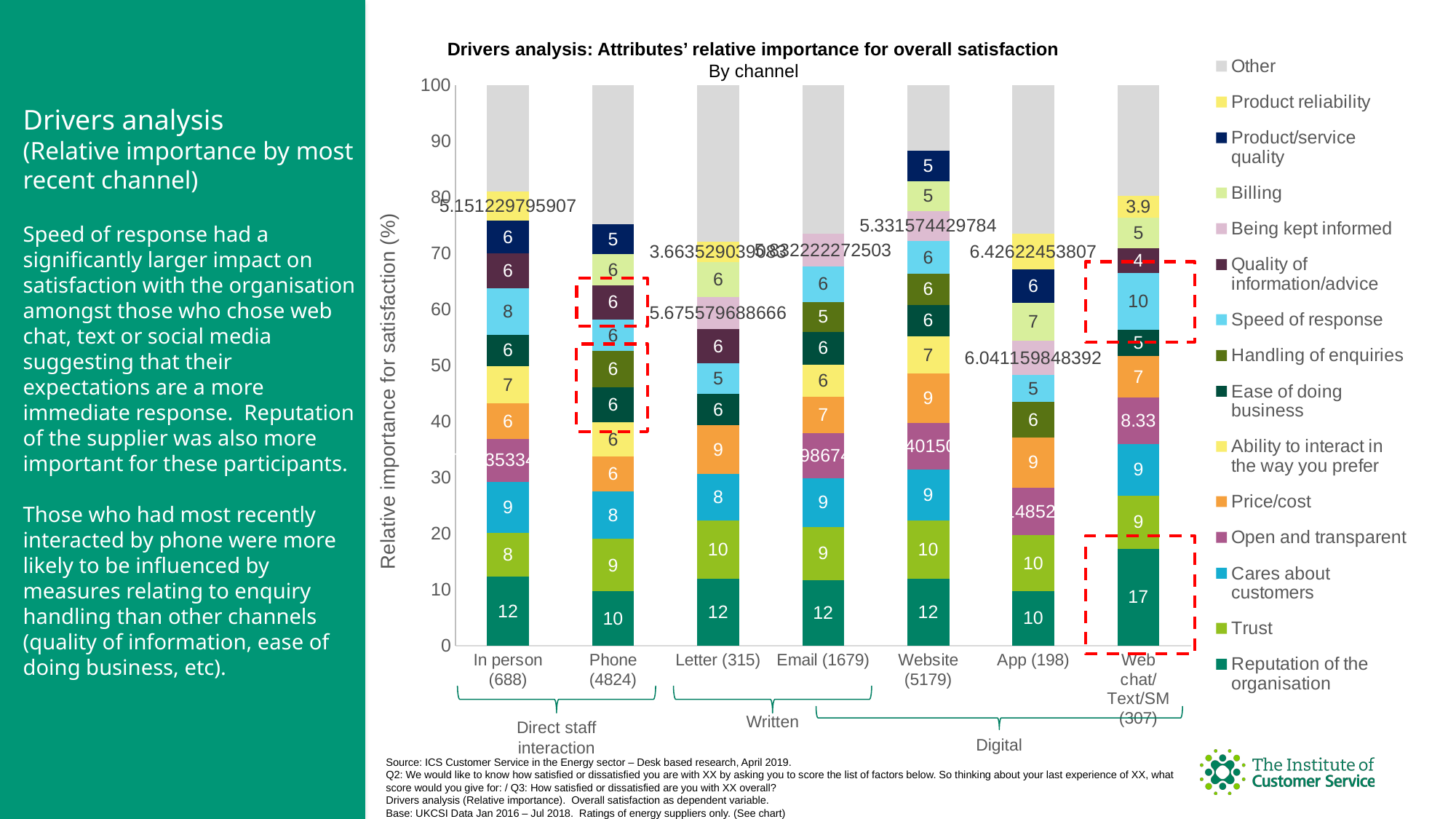
How many channels are plotted along the x axis of the chart? 7 Which channel has the highest value for Reputation of the organisation? Web chat/Text/SM (307) What is the value for Price/cost for the Website (5179) channel? 9 What is the value for Reputation of the organisation for the Web chat/Text/SM (307) channel? 17 What is the title of the chart? Drivers analysis: Attributes' relative importance for overall satisfaction Which has the larger Speed of response value, In person (688) or Phone (4824)? In person (688) What kind of chart is shown on the slide? Stacked bar chart What is the value for Open and transparent for the Web chat/Text/SM (307) channel? 8.33 How many series does the chart's legend list? 15 What is the difference between the Reputation of the organisation values for Web chat/Text/SM (307) and Phone (4824)? 7 Which channel has the lowest value for Trust? In person (688) What is the value for Speed of response for the Web chat/Text/SM (307) channel? 10